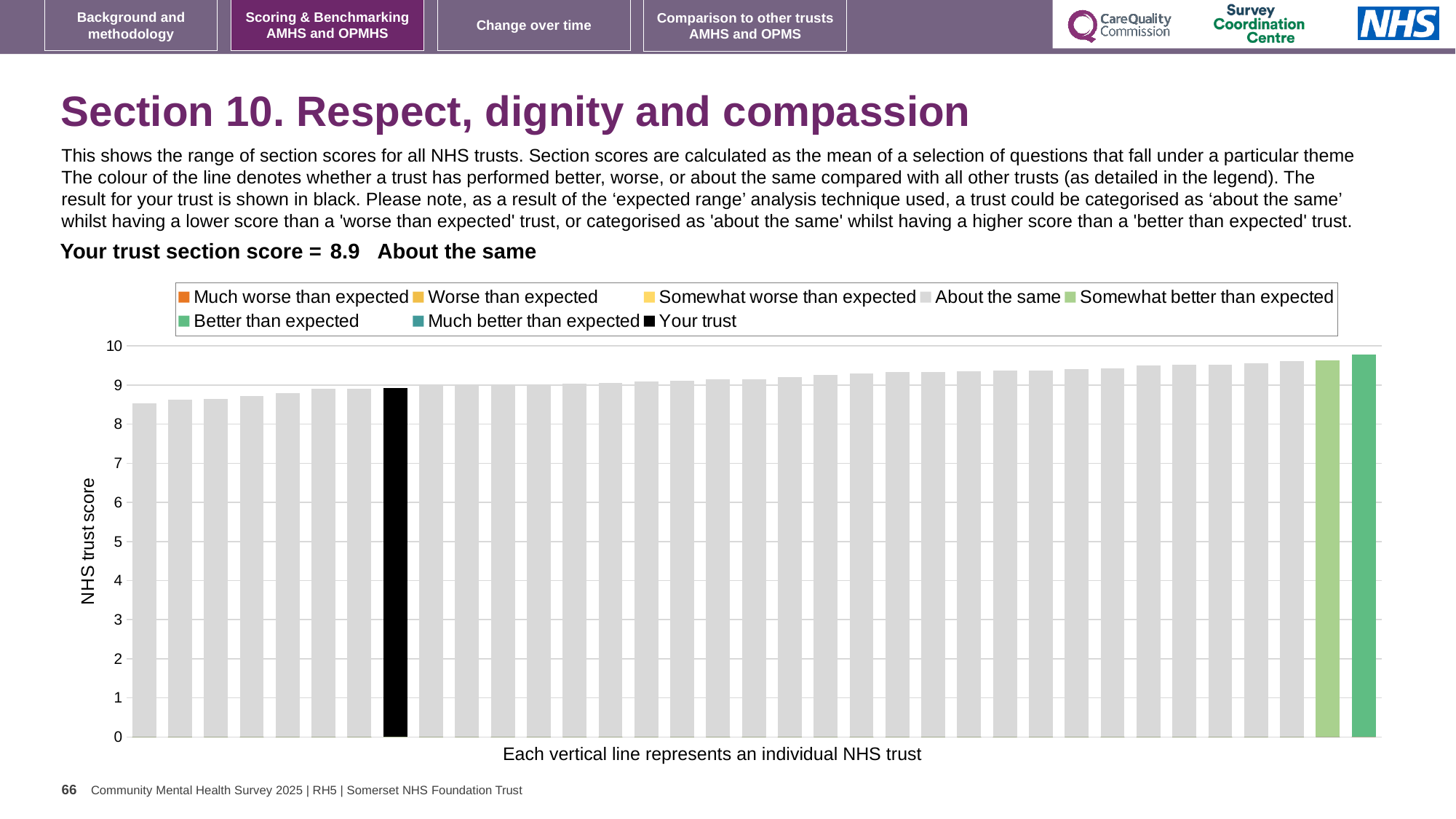
Is the value for the rightmost (tallest) bar greater or less than 9? greater Which legend category does the tallest bar belong to? Better than expected What is the section score for your trust? 8.9 Is the value for the black 'Your trust' bar greater or less than 8? greater Which legend category does the shortest bar belong to? About the same What is the label on the y axis? NHS trust score Do the bar values rise or fall from left to right along the x axis? rise How many categories does the legend list? 8 How many bars are coloured as 'Somewhat better than expected'? 1 What colour is the bar representing your trust? black What kind of chart is shown on the slide? bar chart Is the value for the leftmost (lowest) bar greater or less than 9? less